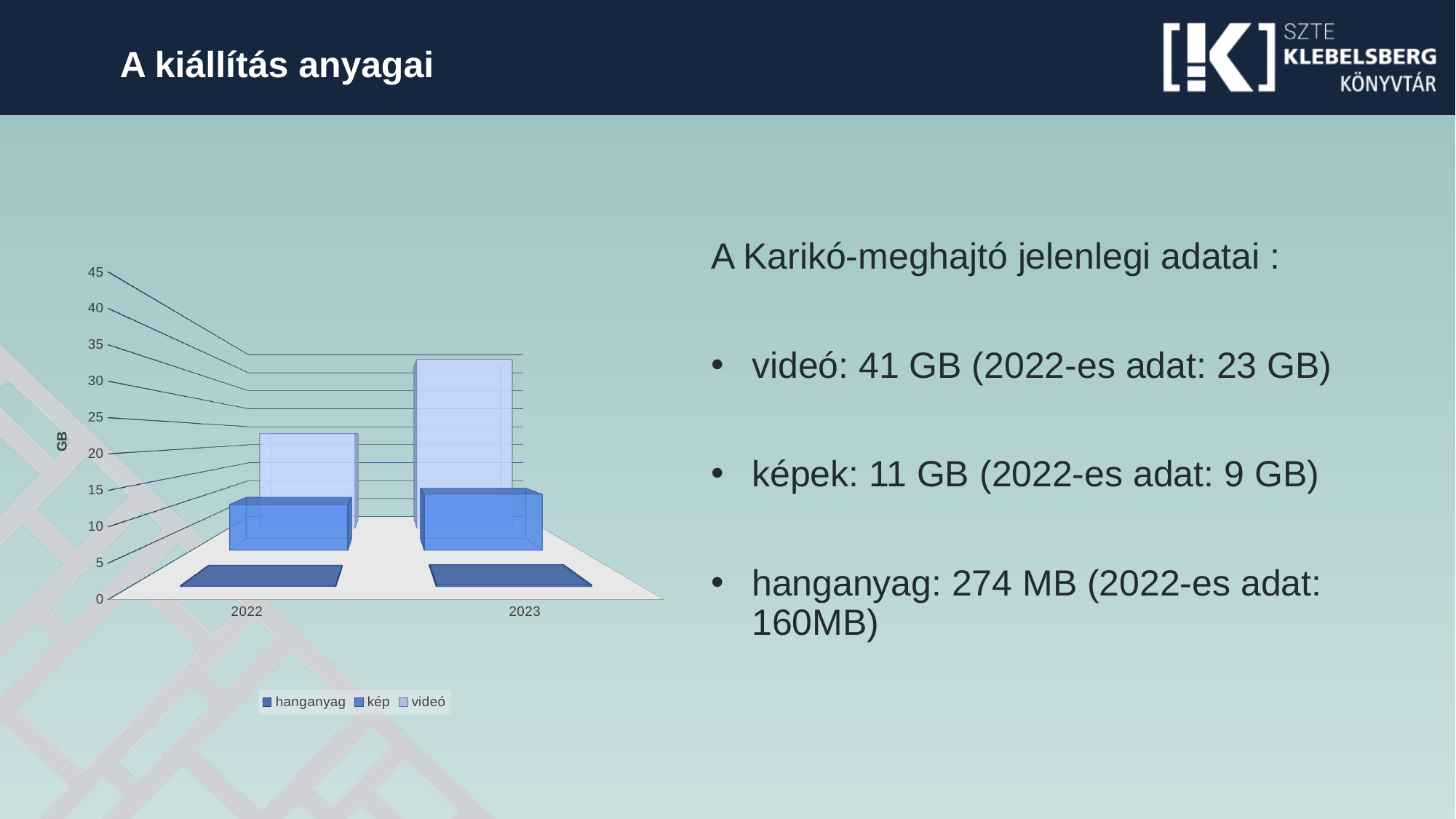
Is the videó bar for 2022 greater or less than 10 GB? greater What is the label on the vertical axis of the chart? GB Which series has the lowest bar for 2023? hanganyag Which is larger in 2022, the videó bar or the kép bar? videó Does the videó series rise or fall from 2022 to 2023? rise How many series does the chart legend list? 3 What kind of chart is shown on the slide? bar chart Which series has the highest bar for 2023? videó Is the hanganyag bar for 2022 greater or less than 5 GB? less Is the videó bar for 2023 greater or less than 25 GB? greater Which is larger, the videó bar for 2022 or the videó bar for 2023? 2023 How many categories are shown on the x axis of the chart? 2